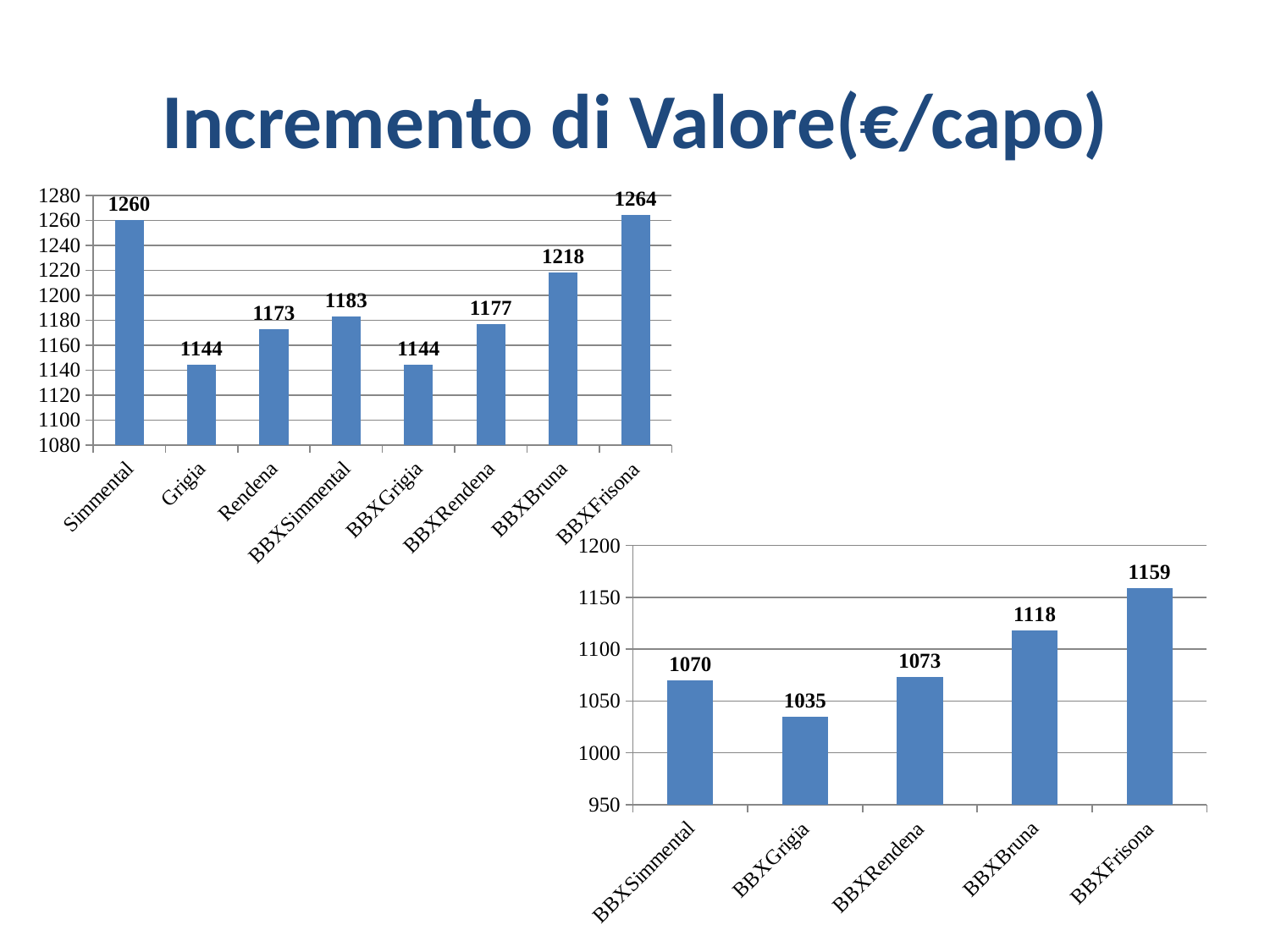
In the bottom-right chart, what is the value for BBXGrigia? 1035 In the top-left chart, what is the value for BBXBruna? 1218 In the bottom-right chart, how many categories are shown? 5 In the top-left chart, which is larger, the value for Rendena or the value for BBXRendena? BBXRendena What kind of chart is the bottom-right chart? Bar chart In the bottom-right chart, what is the difference between the values for BBXFrisona and BBXBruna? 41 In the top-left chart, how many bars are plotted? 8 In the top-left chart, what is the difference between the values for BBXFrisona and Simmental? 4 In the top-left chart, which category has the highest value? BBXFrisona What is the title of the slide? Incremento di Valore(€/capo) In the bottom-right chart, which category has the lowest value? BBXGrigia In the top-left chart, what is the value for Grigia? 1144